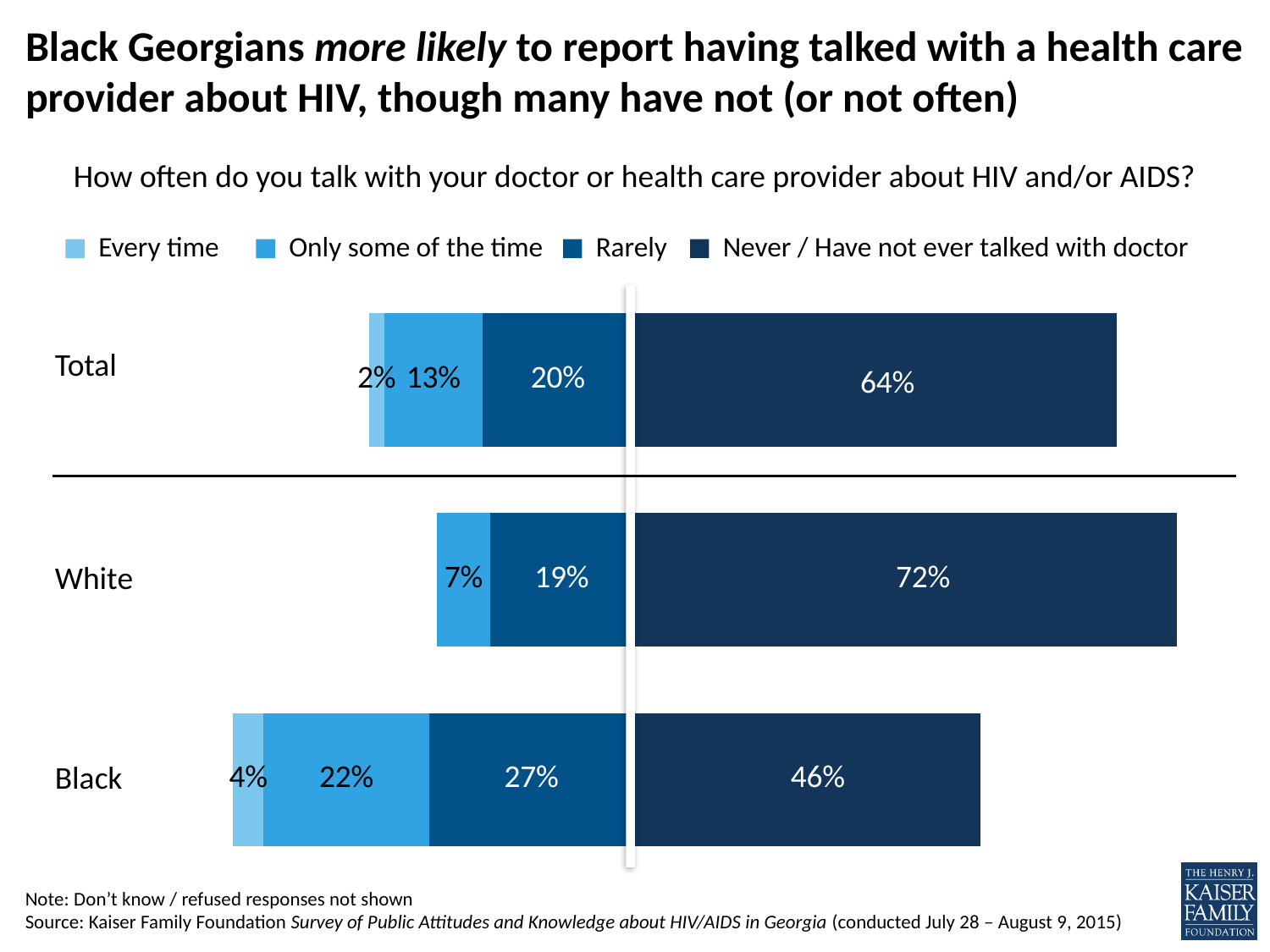
What is the 'Rarely' value for the Total group? 20% What is the difference between the 'Never / Have not ever talked with doctor' values for White and Black respondents? 26% What percentage of White respondents say they talk with their doctor about HIV only some of the time? 7% How many series does the legend list? 4 What is the sum of the labeled segments in the Black bar? 99% What is the 'Every time' value for Black respondents? 4% Which group has the highest 'Never / Have not ever talked with doctor' value? White What percentage of Black respondents say they never / have not ever talked with a doctor about HIV? 46% How many groups (bars) are shown in the chart? 3 What kind of chart is shown on the slide? Stacked bar chart Which is larger: the 'Rarely' value for Black respondents or for the Total group? Black Which group has the lowest 'Only some of the time' value? White